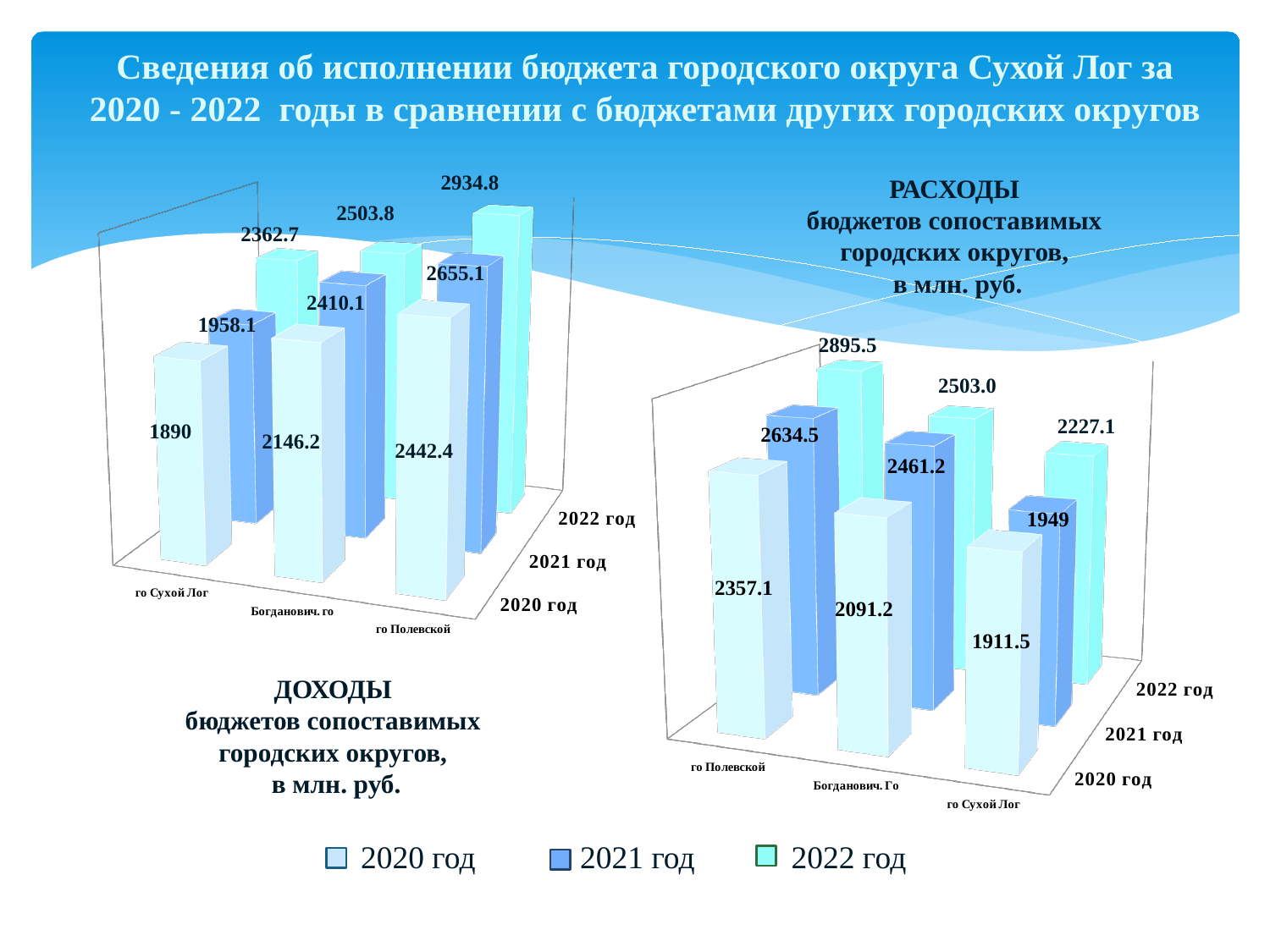
On the ДОХОДЫ chart (left), which city district has the lowest value in 2020 год? го Сухой Лог On the ДОХОДЫ chart (left), what is the value for го Сухой Лог in 2020 год? 1890 On the ДОХОДЫ chart (left), what is the value for Богданович. го in 2021 год? 2410.1 On the ДОХОДЫ chart (left), do the values for го Полевской rise or fall from 2020 год to 2022 год? rise On the РАСХОДЫ chart (right), which city district has the highest value in 2022 год? го Полевской On the ДОХОДЫ chart (left), what is the value for го Полевской in 2022 год? 2934.8 What kind of chart is the РАСХОДЫ chart (right)? bar chart On the РАСХОДЫ chart (right), which is larger for Богданович. Го: the 2021 год value or the 2022 год value? 2022 год On the РАСХОДЫ chart (right), what is the value for го Полевской in 2020 год? 2357.1 On the РАСХОДЫ chart (right), what is the value for го Сухой Лог in 2021 год? 1949 On the ДОХОДЫ chart (left), what is the difference between the 2022 год and 2020 год values for го Сухой Лог? 472.7 How many series does the legend list? 3